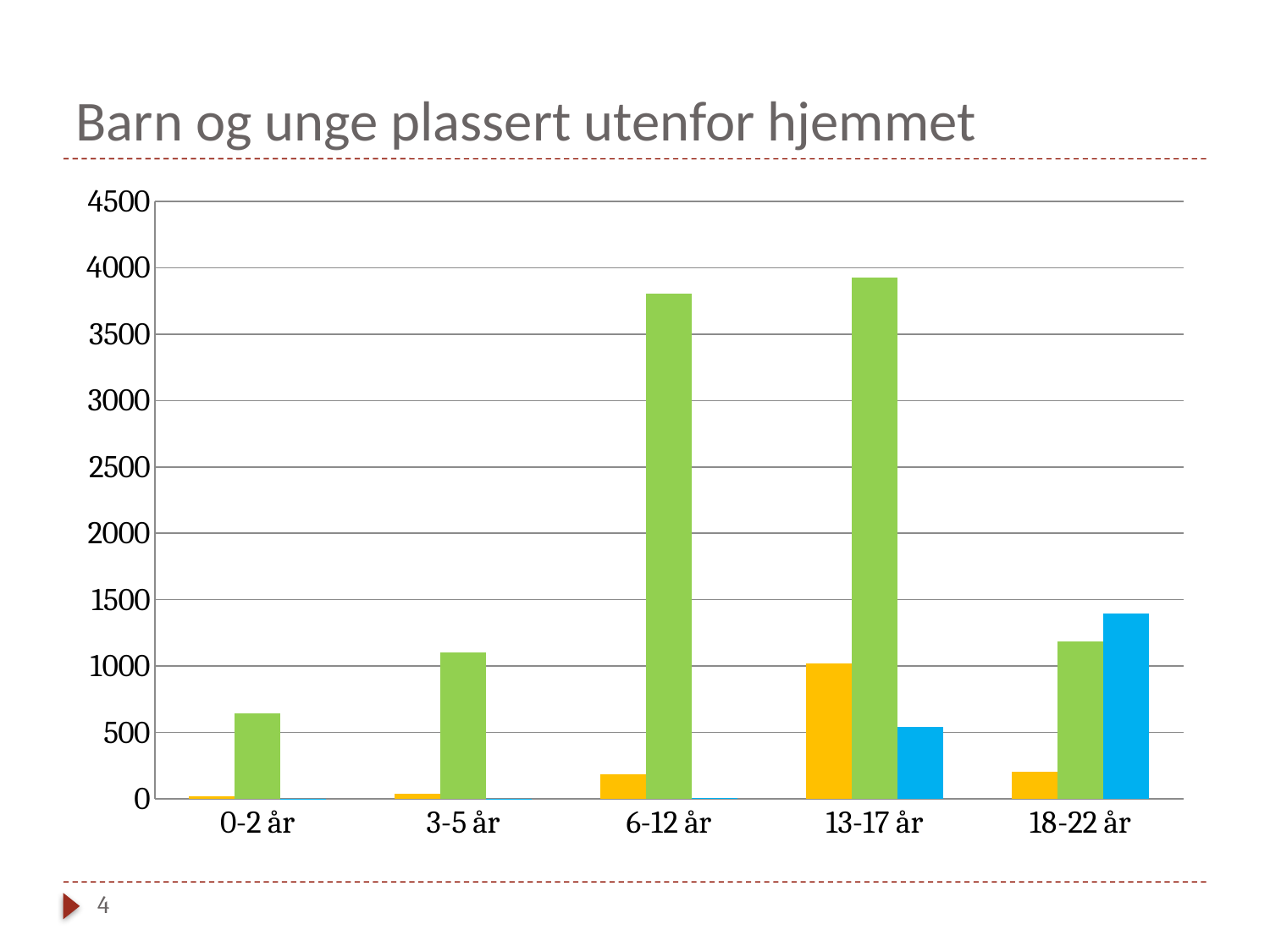
Which age group has the tallest blue bar? 18-22 år What is the title of the chart? Barn og unge plassert utenfor hjemmet Which age group has the shortest green bar? 0-2 år For 18-22 år, which is larger, the blue bar or the orange bar? the blue bar How many differently coloured bar series are plotted in the chart? 3 How many age-group categories are shown on the x axis? 5 Do the green bars rise or fall from 0-2 år to 13-17 år? rise What kind of chart is shown on the slide? bar chart Is the green bar for 6-12 år greater or less than 3500? greater Is the blue bar for 18-22 år greater or less than 1500? less Which age group has the tallest green bar? 13-17 år Which age group has the tallest orange bar? 13-17 år